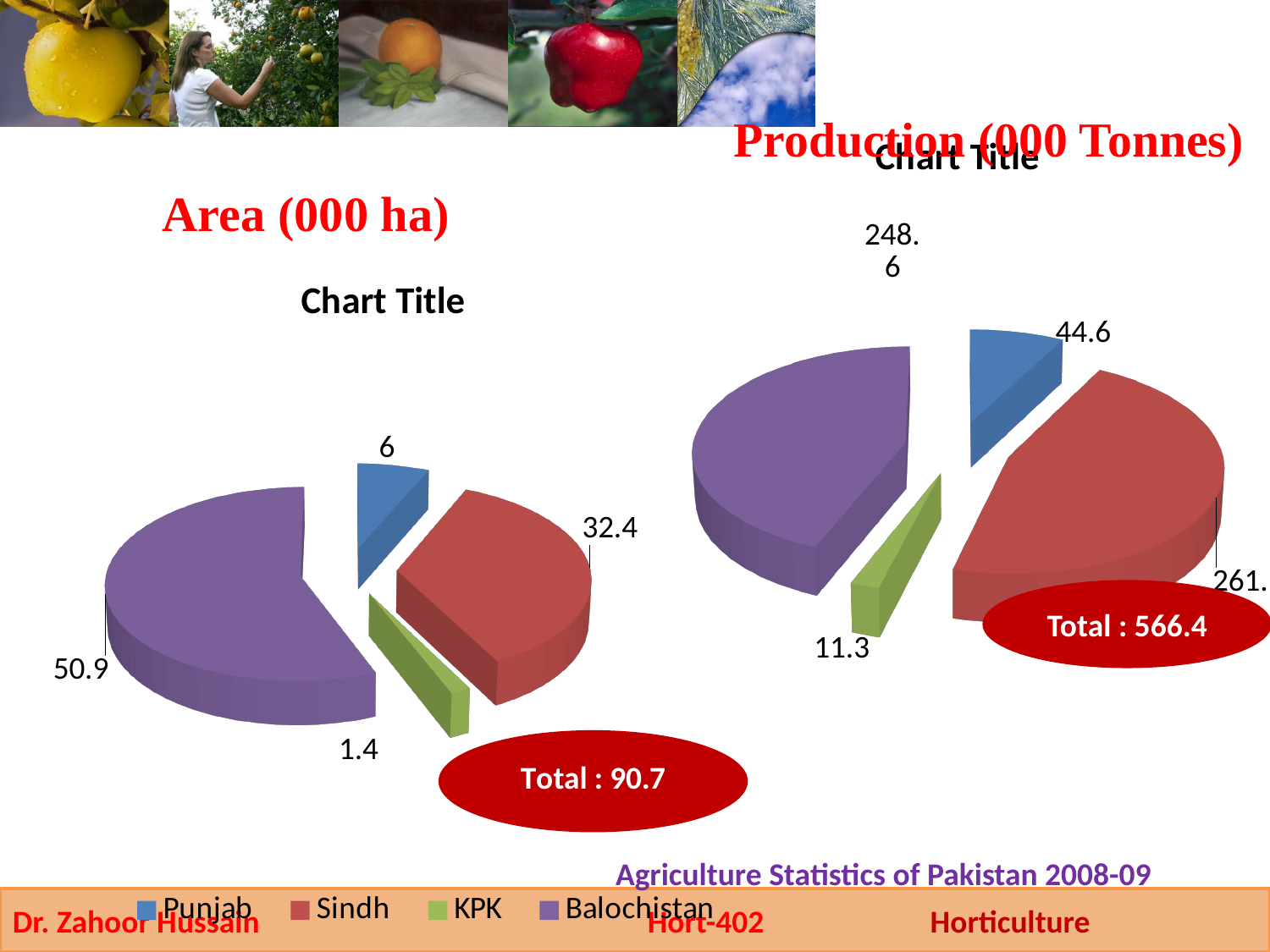
In the Area (000 ha) chart, what is the value for Balochistan? 50.9 What total is shown for the Area (000 ha) chart? 90.7 In the Area (000 ha) chart, which province has the largest slice? Balochistan In the Area (000 ha) chart, which is larger, the value for Punjab or the value for KPK? Punjab In the Production (000 Tonnes) chart, what is the value for Punjab? 44.6 In the Production (000 Tonnes) chart, what is the value for KPK? 11.3 In the Area (000 ha) chart, which province has the smallest slice? KPK What kind of chart is the Area (000 ha) chart on the left? pie chart In the Production (000 Tonnes) chart, which province has the smallest slice? KPK How many provinces does the legend list? 4 In the Area (000 ha) chart, what is the difference between the values for Balochistan and Sindh? 18.5 In the Area (000 ha) chart, what is the value for Sindh? 32.4